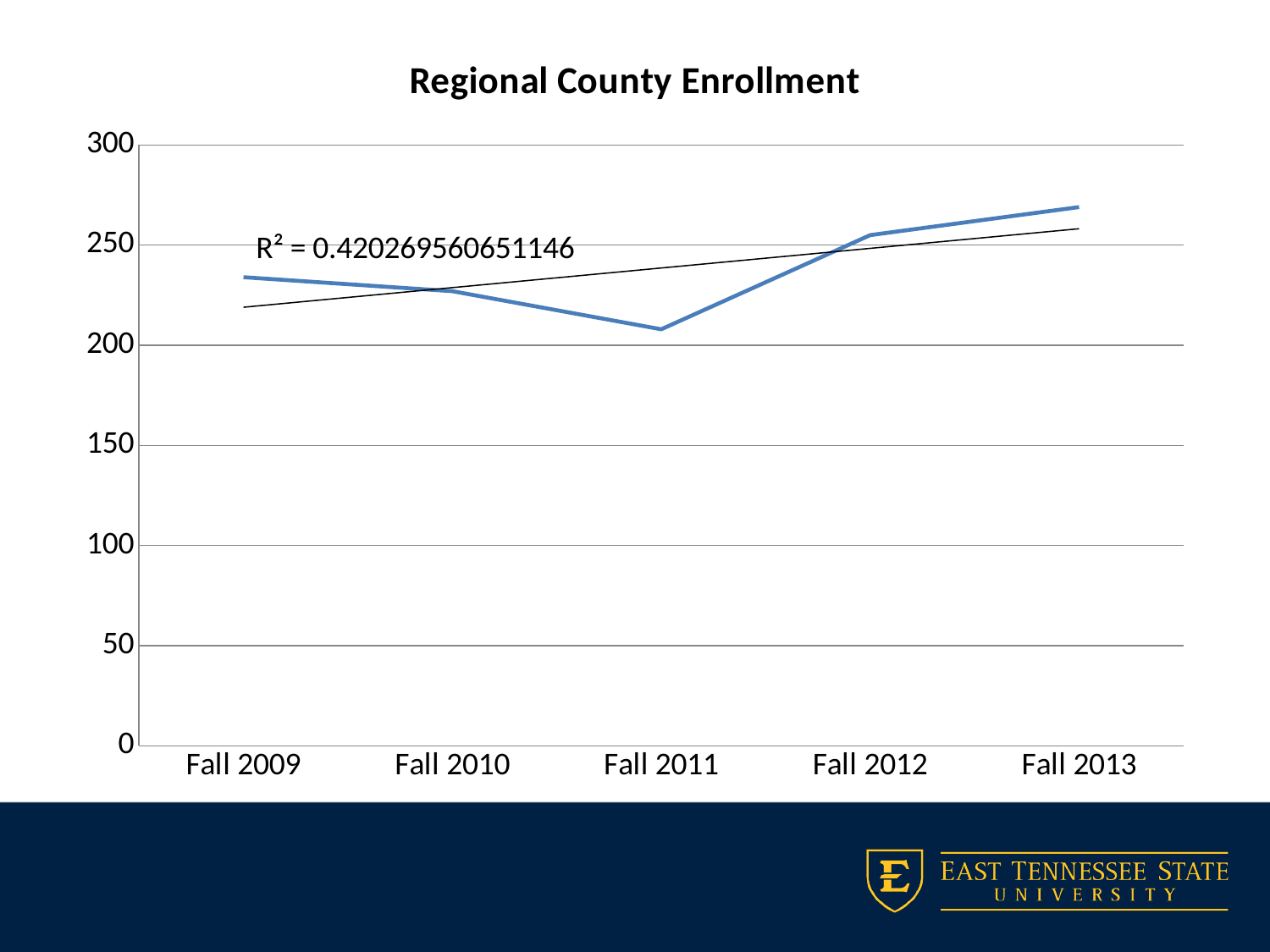
Which term has the lowest enrollment? Fall 2011 Which is larger, the value for Fall 2012 or the value for Fall 2013? Fall 2013 Which term has the highest enrollment? Fall 2013 Is the value for Fall 2013 greater or less than 250? greater What is the title of the chart? Regional County Enrollment What type of chart is shown on the slide? line chart How many time points are plotted along the x axis? 5 Which is larger, the value for Fall 2009 or the value for Fall 2011? Fall 2009 Is the value for Fall 2011 greater or less than 250? less Do the values rise or fall from Fall 2011 to Fall 2013? rise What R² value is printed on the chart for the trendline? R² = 0.420269560651146 Is the value for Fall 2009 greater or less than 200? greater